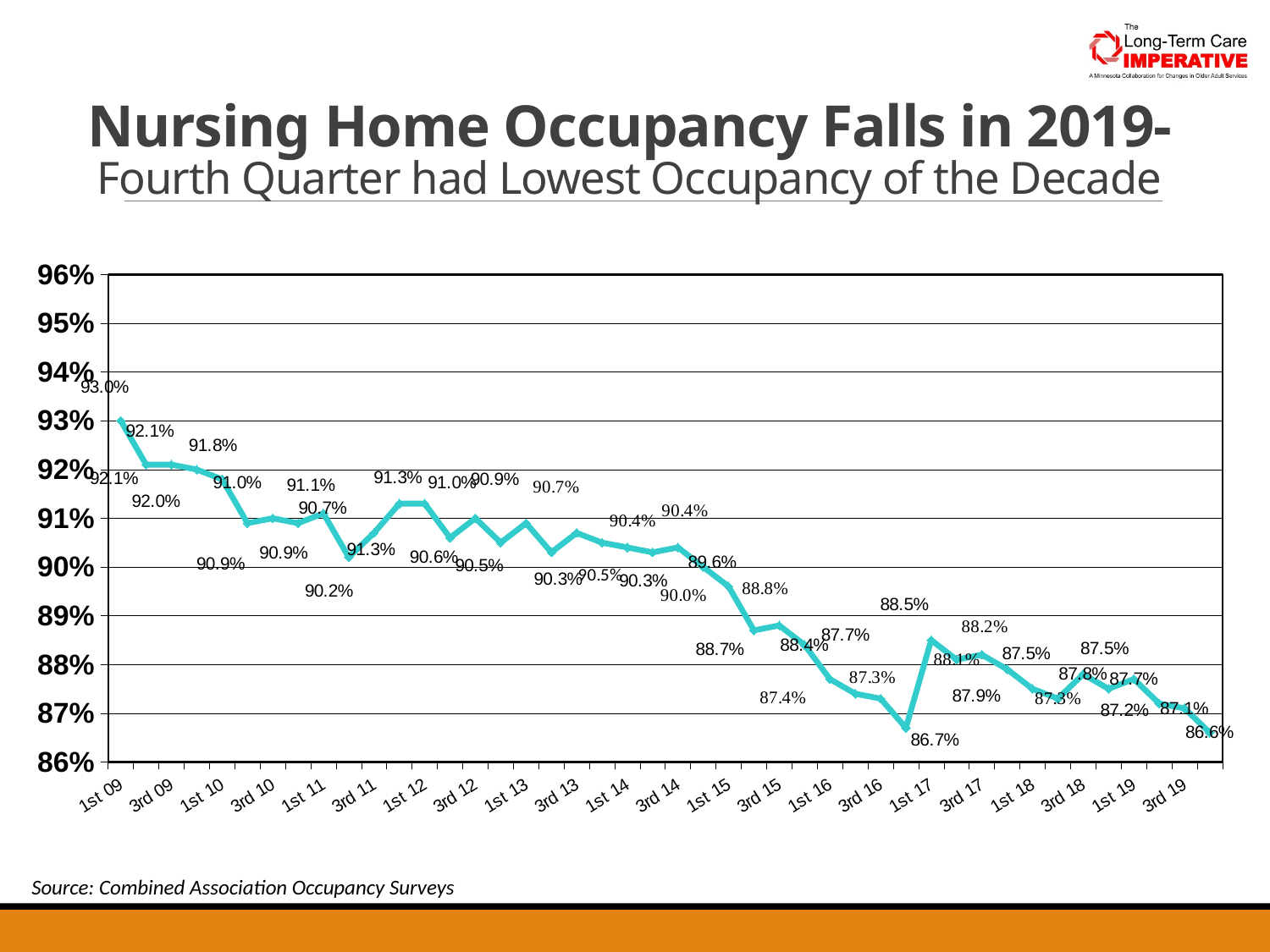
How many quarter labels are shown along the x axis? 22 Which has the higher occupancy, 1st 09 or 3rd 19? 1st 09 What is the difference between the first point (93.0%) and the last point (86.6%) on the chart? 6.4 percentage points What source is cited for the chart data? Combined Association Occupancy Surveys Is the value for 1st 12 greater or less than 91%? greater Which quarter has the highest occupancy on the chart? 1st 09 What kind of chart is shown on the slide? line chart Is the value for 3rd 19 greater or less than 88%? less Is the value for 1st 15 greater or less than 89%? greater What is the occupancy value for the final point on the chart (4th quarter 2019)? 86.6% Overall, do occupancy values rise or fall from 1st 09 to 3rd 19? fall What is the occupancy value for 1st 09, the first point on the chart? 93.0%